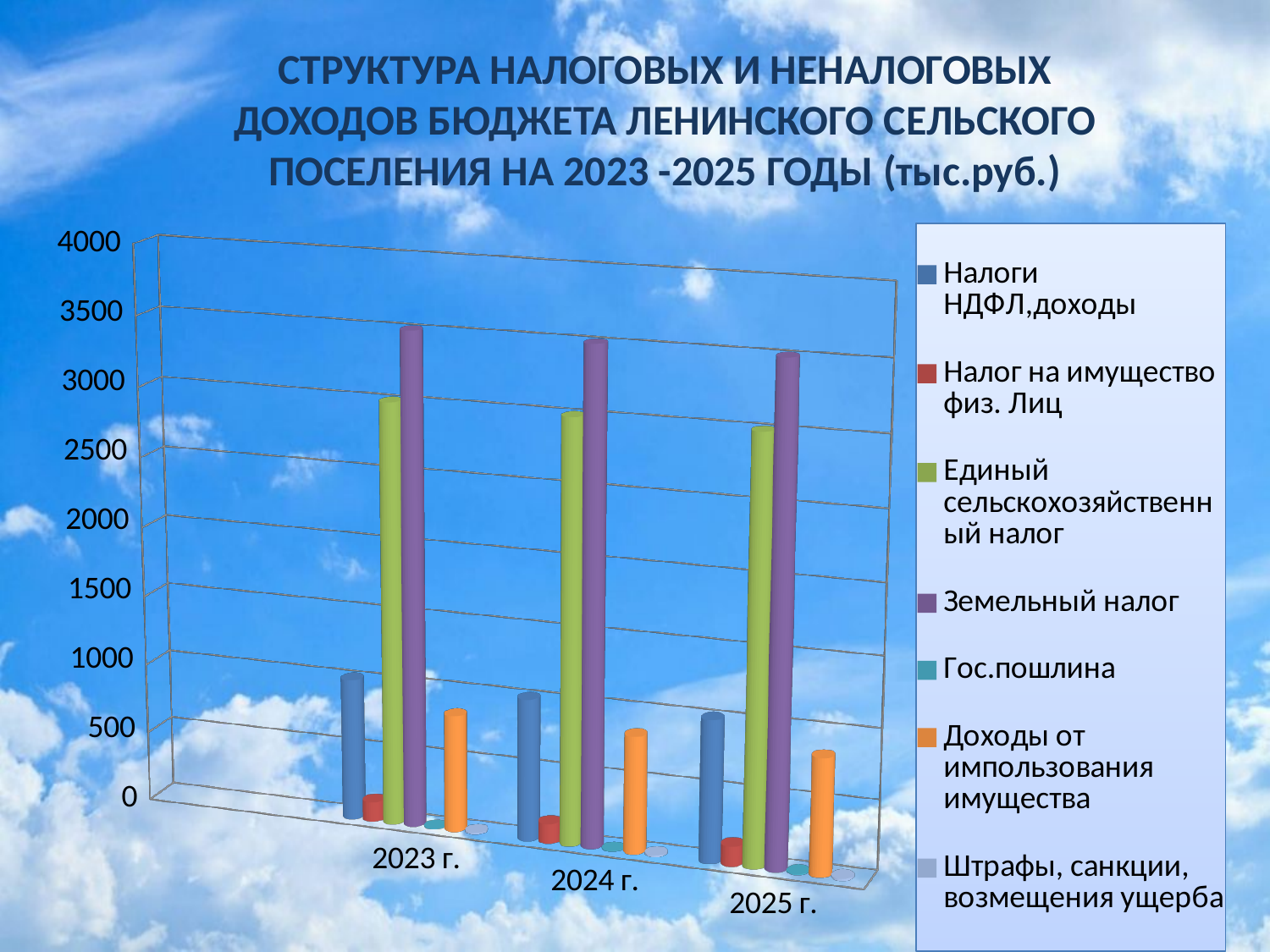
How many series does the legend list? 7 How many year categories are shown on the x axis? 3 Is the value for Земельный налог in 2023 г. greater or less than 3000? greater What kind of chart is shown on the slide? bar chart Which is larger in 2024 г.: Единый сельскохозяйственный налог or Налоги НДФЛ,доходы? Единый сельскохозяйственный налог Which series has the highest value in 2025 г.? Земельный налог Which series has the highest value in 2023 г.? Земельный налог Which colour represents Земельный налог in the legend? purple